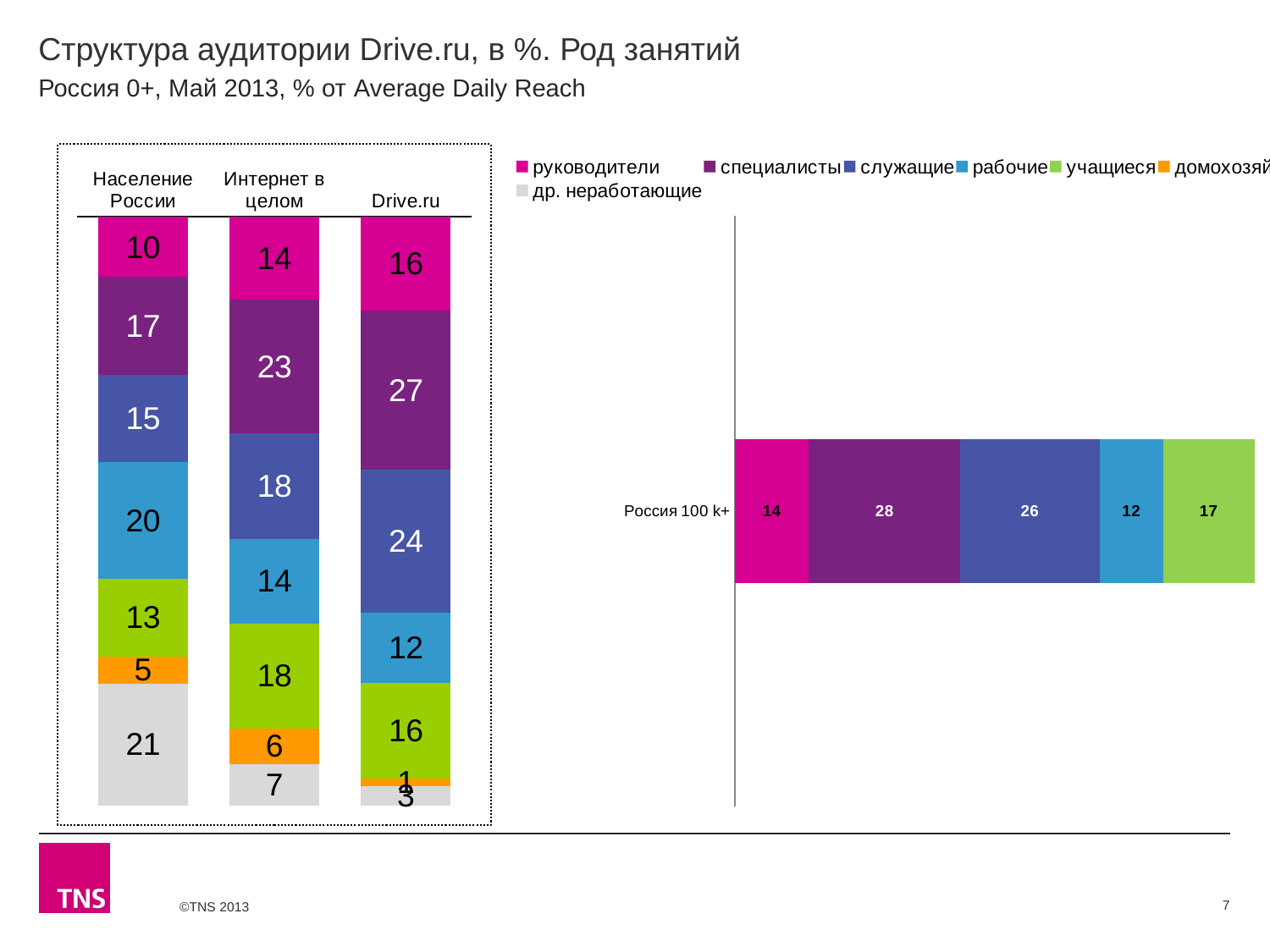
In the left chart, what is the value for специалисты in the Drive.ru bar? 27 In the left chart, what is the value for служащие in the Интернет в целом bar? 18 In the right chart (Россия 100 k+), which category has the smallest segment? рабочие In the right chart (Россия 100 k+), which category has the largest segment? специалисты In the right chart (Россия 100 k+), what is the value for специалисты? 28 In the left chart, how much larger is the руководители value for Drive.ru than for Население России? 6 How many bars are shown in the left chart? 3 In the left chart, what is the value for др. неработающие in the Население России bar? 21 In the left chart, which bar has the larger служащие value: Drive.ru or Интернет в целом? Drive.ru In the left chart, what is the value for рабочие in the Население России bar? 20 What is the total of the Россия 100 k+ bar in the right chart? 97 How many series does the legend list? 7